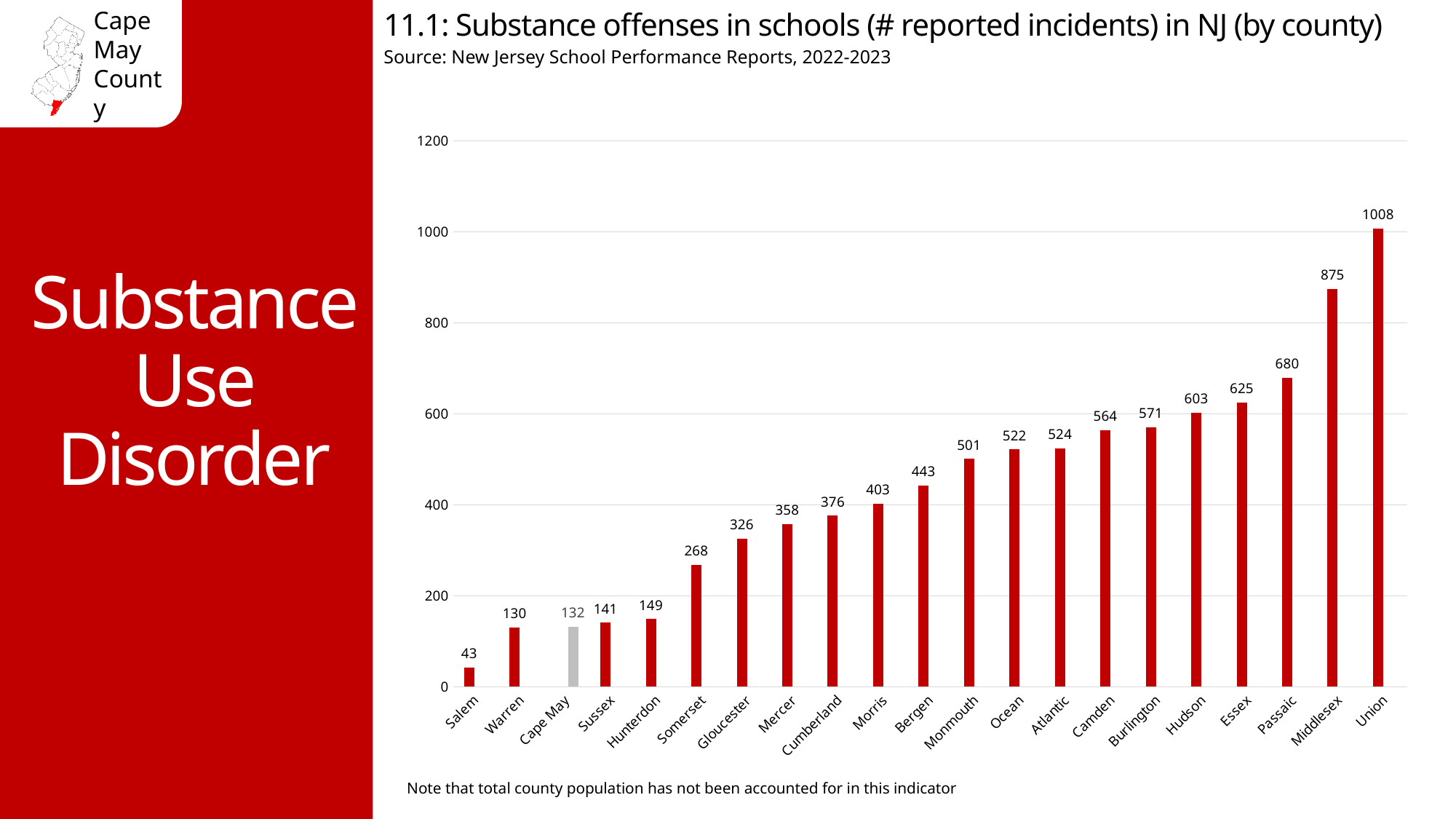
Which county's bar is shown in gray rather than red? Cape May What is the difference between the values for Middlesex and Passaic? 195 Is the value for Bergen greater or less than 400? greater What is the number of reported substance offense incidents in schools for Cape May County? 132 Which county has the lowest number of reported incidents? Salem Which county has the highest number of reported incidents? Union What is the difference between the values for Cape May and Salem? 89 What is the value shown for Union County? 1008 What is the value shown for Monmouth County? 501 What kind of chart is shown on the slide? Bar chart Which county has a larger value, Hudson or Essex? Essex How many counties are shown on the chart? 21